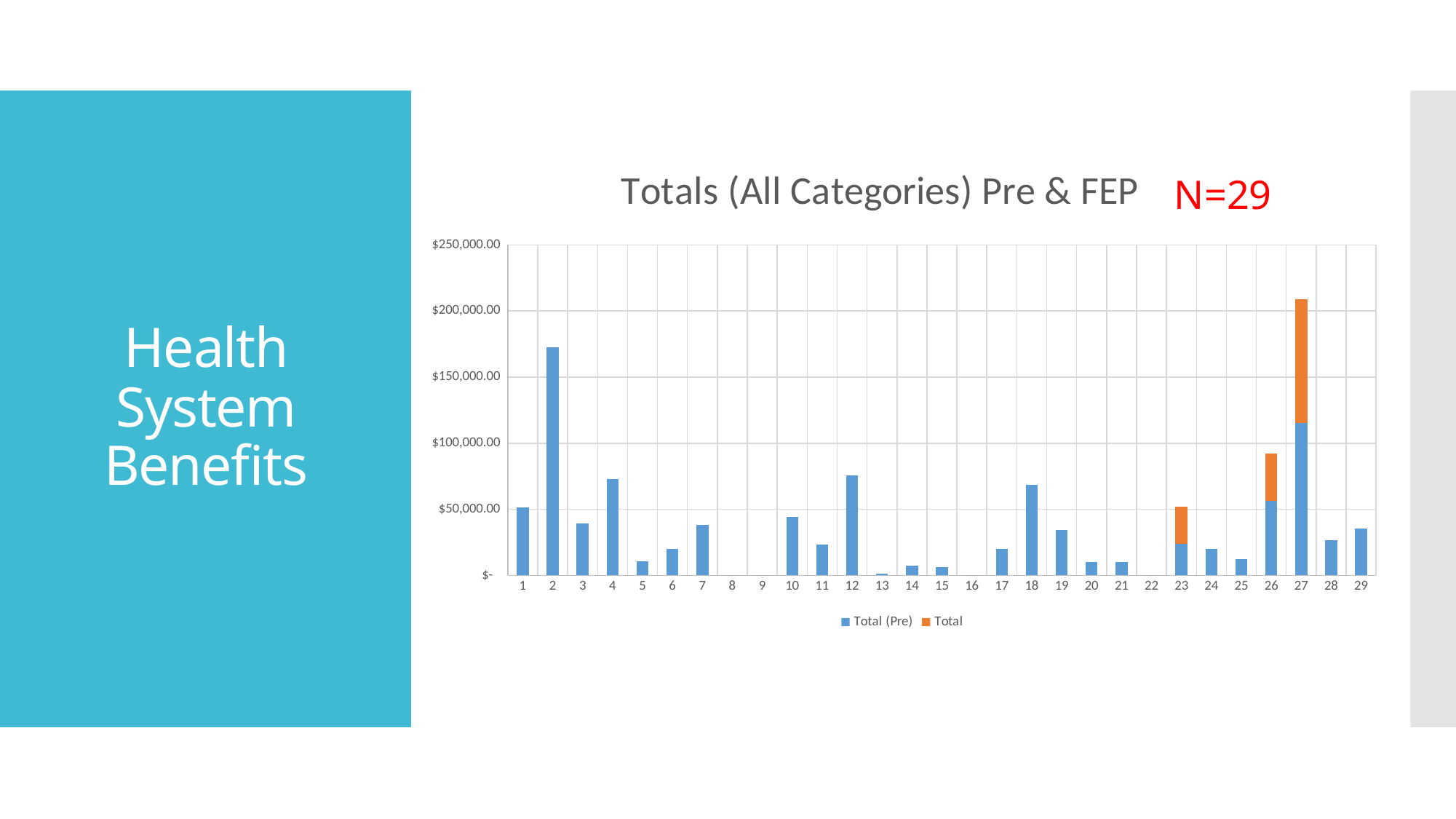
Which category has the tallest Total (Pre) bar? 2 Is the value for category 4 greater or less than $50,000.00? greater Which is larger, the bar for category 18 or the bar for category 19? Category 18 Is the value for category 2 greater or less than $150,000.00? greater What are the two series named in the legend? Total (Pre) and Total Is the value for category 12 greater or less than $100,000.00? less How many categories are shown along the x axis? 29 How many categories include an orange Total segment? 3 What is the title of the chart? Totals (All Categories) Pre & FEP How many series does the chart legend list? 2 Which category has the tallest stacked bar overall? 27 What type of chart is shown on the slide? Stacked bar chart